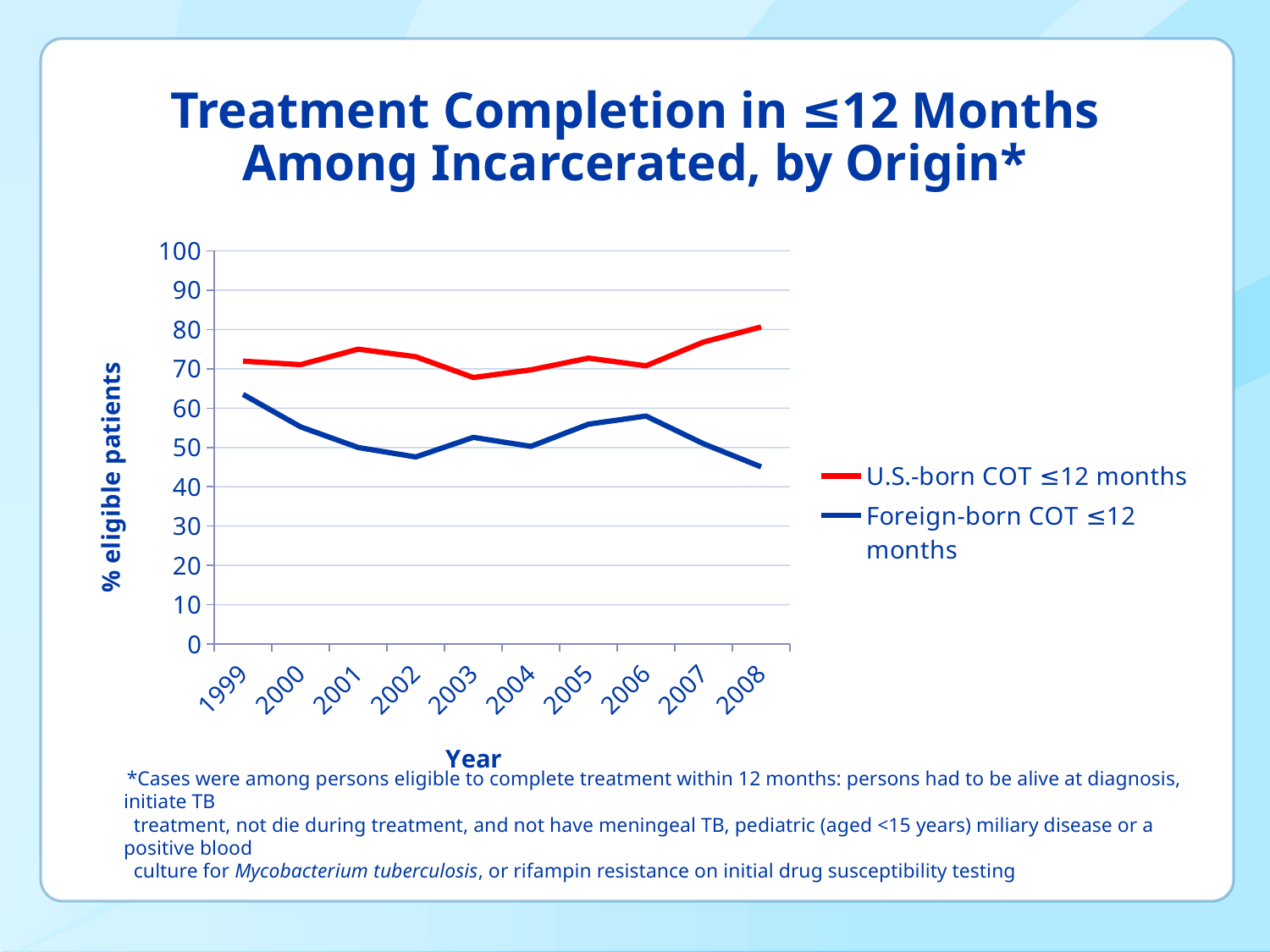
Is the value for U.S.-born COT ≤12 months in 2001 greater or less than 70? greater What type of chart is shown on the slide? Line chart Is the value for Foreign-born COT ≤12 months in 2002 greater or less than 50? less In which year is the U.S.-born COT ≤12 months series at its highest? 2008 What is the label of the y axis? % eligible patients Is the value for U.S.-born COT ≤12 months in 2003 greater or less than 70? less How many years are plotted along the x axis? 10 In 2008, which series has the larger value, U.S.-born or Foreign-born COT ≤12 months? U.S.-born COT ≤12 months How many series does the legend list? 2 Does the Foreign-born COT ≤12 months series rise or fall from 2006 to 2008? Fall In which year is the Foreign-born COT ≤12 months series at its highest? 1999